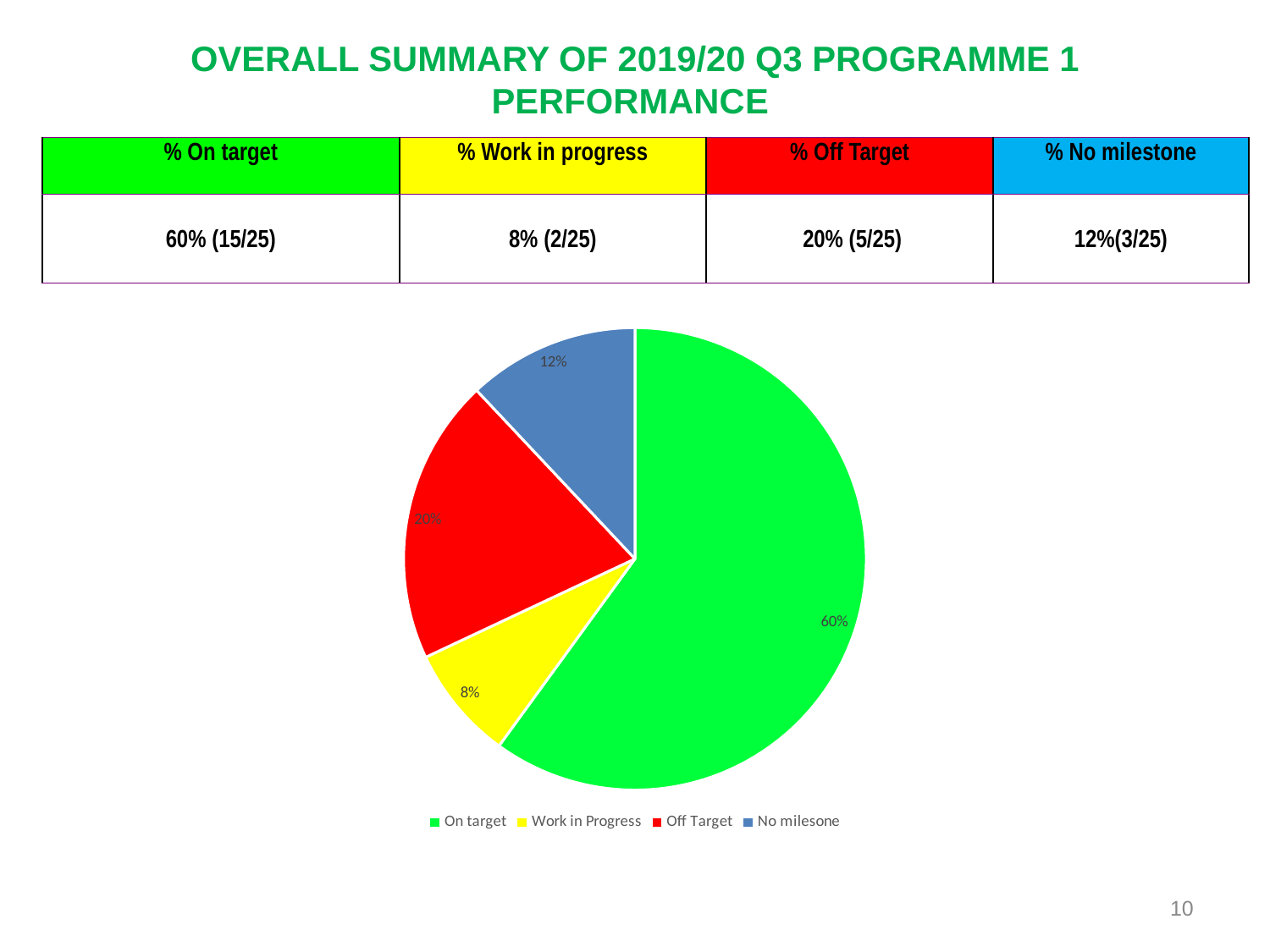
What share of the pie does the Off Target slice represent? 20% What kind of chart is shown on the slide? Pie chart Which slice of the pie is the smallest? Work in Progress Which is larger, the Off Target slice or the No milesone slice? Off Target How many entries does the legend list? 4 What is the difference in percentage points between the On target slice and the Off Target slice? 40 Which slice of the pie is the largest? On target What share of the pie does the Work in Progress slice represent? 8% What share of the pie does the No milesone slice represent? 12% What colour is the Off Target slice in the pie chart? Red How many slices does the pie chart have? 4